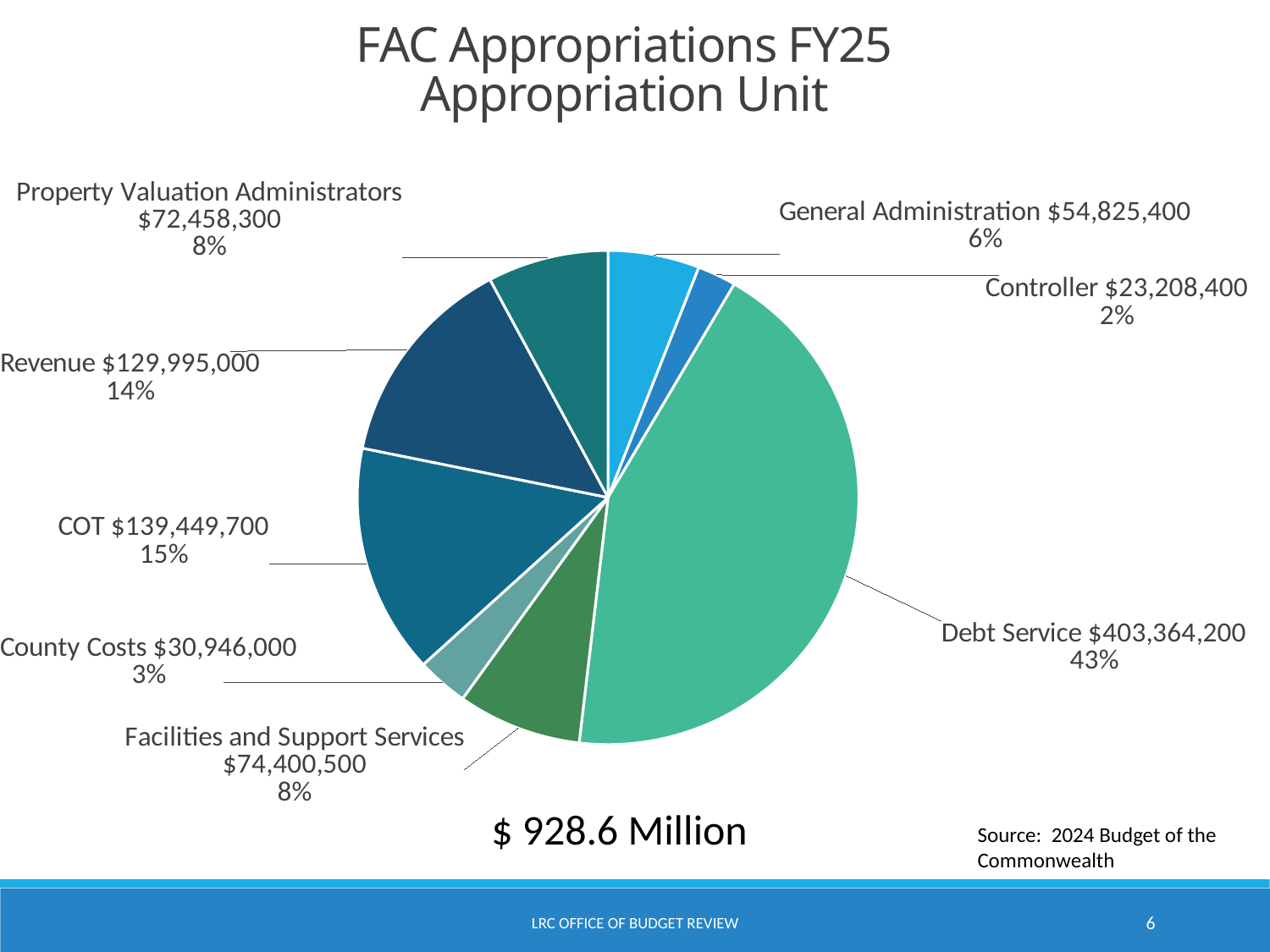
Which appropriation unit has the smallest slice of the pie? Controller What kind of chart is shown on the slide? Pie chart What is the appropriation amount for Debt Service? $403,364,200 What share of the pie does General Administration represent? 6% What is the appropriation amount for Controller? $23,208,400 What share of the pie does Revenue represent? 14% What is the appropriation amount for COT? $139,449,700 What total amount is shown below the pie chart? $ 928.6 Million Which is larger, the appropriation for COT or for Revenue? COT What is the difference between the appropriations for Facilities and Support Services and Property Valuation Administrators? $1,942,200 How many appropriation units are shown in the pie chart? 8 Which appropriation unit has the largest slice of the pie? Debt Service